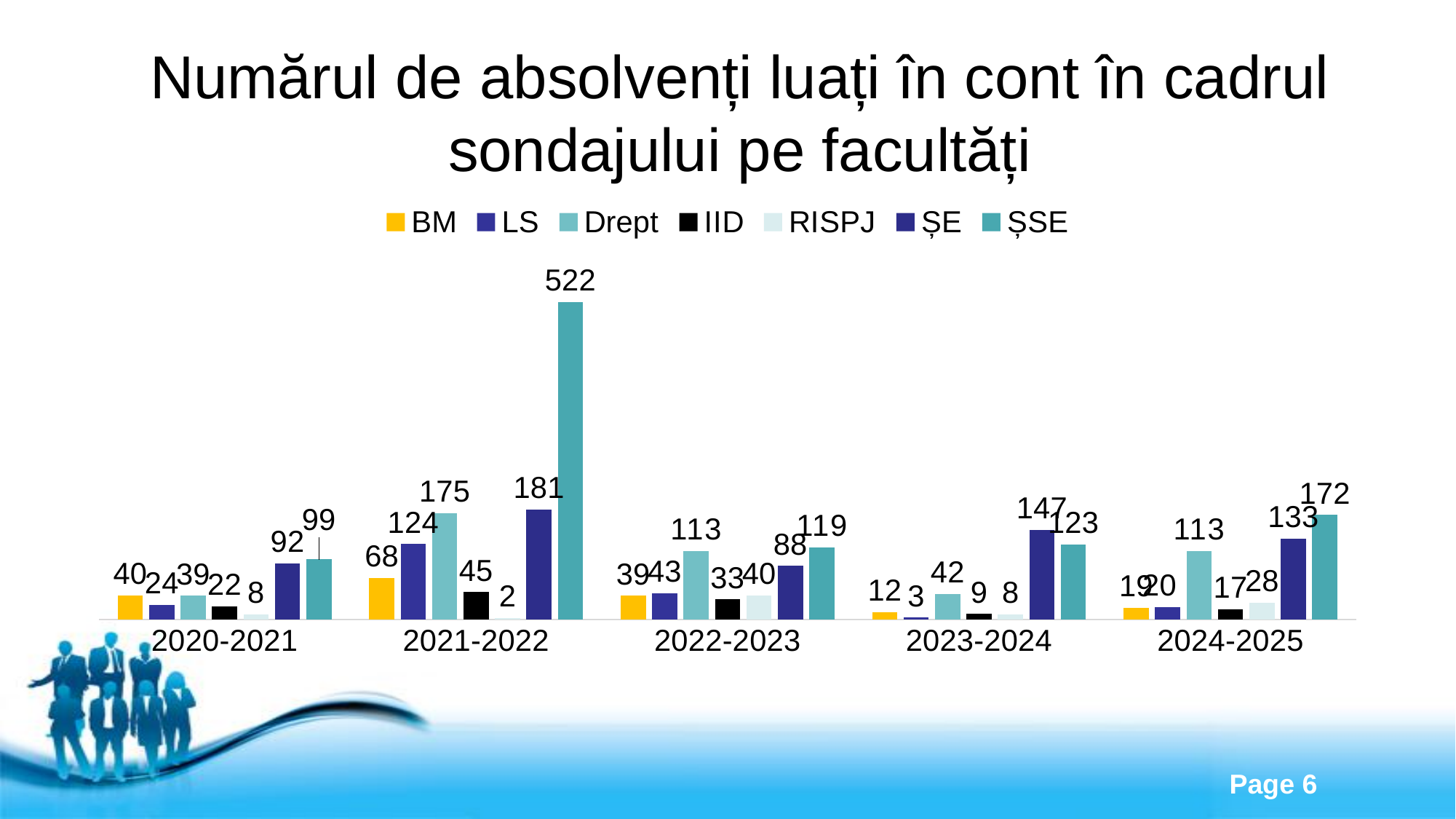
What is the value for ȘE in 2023-2024? 147 Which is larger in 2023-2024, ȘE or ȘSE? ȘE What is the value for ȘSE in 2021-2022? 522 What is the title of the chart? Numărul de absolvenți luați în cont în cadrul sondajului pe facultăți Which series has the highest value in 2020-2021? ȘSE What is the value for Drept in 2021-2022? 175 Which series has the lowest value in 2021-2022? RISPJ How many academic years are shown on the x axis? 5 What kind of chart is shown on the slide? Bar chart What is the value for IID in 2022-2023? 33 How many series does the legend list? 7 What is the difference between the ȘSE values for 2021-2022 and 2022-2023? 403